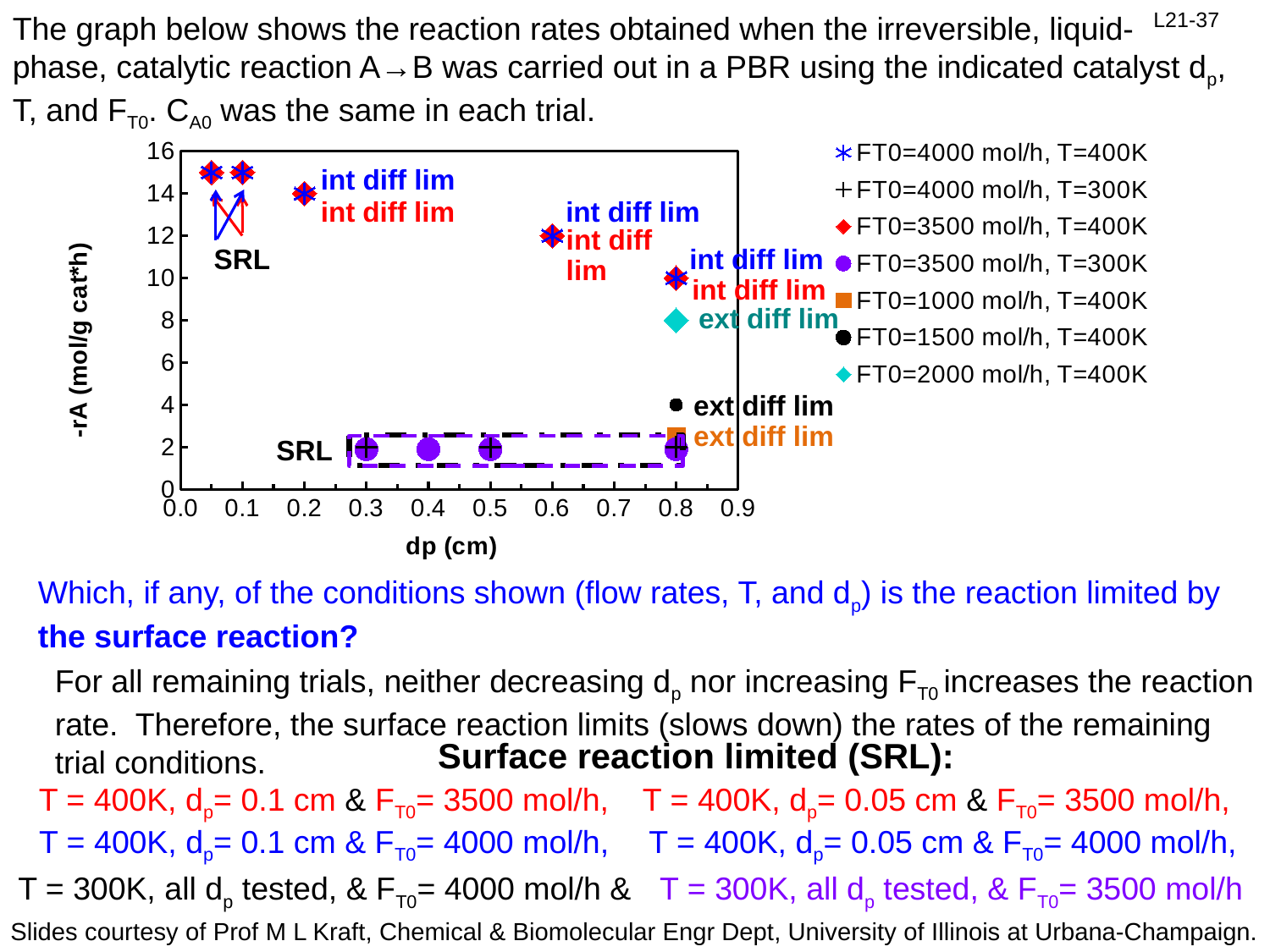
What is the x-axis title of the chart? dp (cm) What is the reaction rate -rA for FT0=4000 mol/h, T=400K at dp = 0.2 cm? 14 What is the reaction rate -rA for FT0=1500 mol/h, T=400K at dp = 0.8 cm? 4 For FT0=4000 mol/h, T=400K, what is the difference in reaction rate between dp = 0.6 cm and dp = 0.8 cm? 2 Is the reaction rate for FT0=1000 mol/h, T=400K at dp = 0.8 cm greater or less than 4? less What type of chart is shown on the slide? Scatter chart At dp = 0.8 cm, which has the higher reaction rate: FT0=2000 mol/h, T=400K or FT0=1500 mol/h, T=400K? FT0=2000 mol/h, T=400K Is the reaction rate for FT0=4000 mol/h, T=400K at dp = 0.05 cm greater or less than 14? greater For FT0=4000 mol/h, T=400K, does the reaction rate rise or fall as dp increases? Falls What is the y-axis title of the chart? -rA (mol/g cat*h) How many series does the chart legend list? 7 What is the reaction rate -rA for FT0=2000 mol/h, T=400K at dp = 0.8 cm? 8